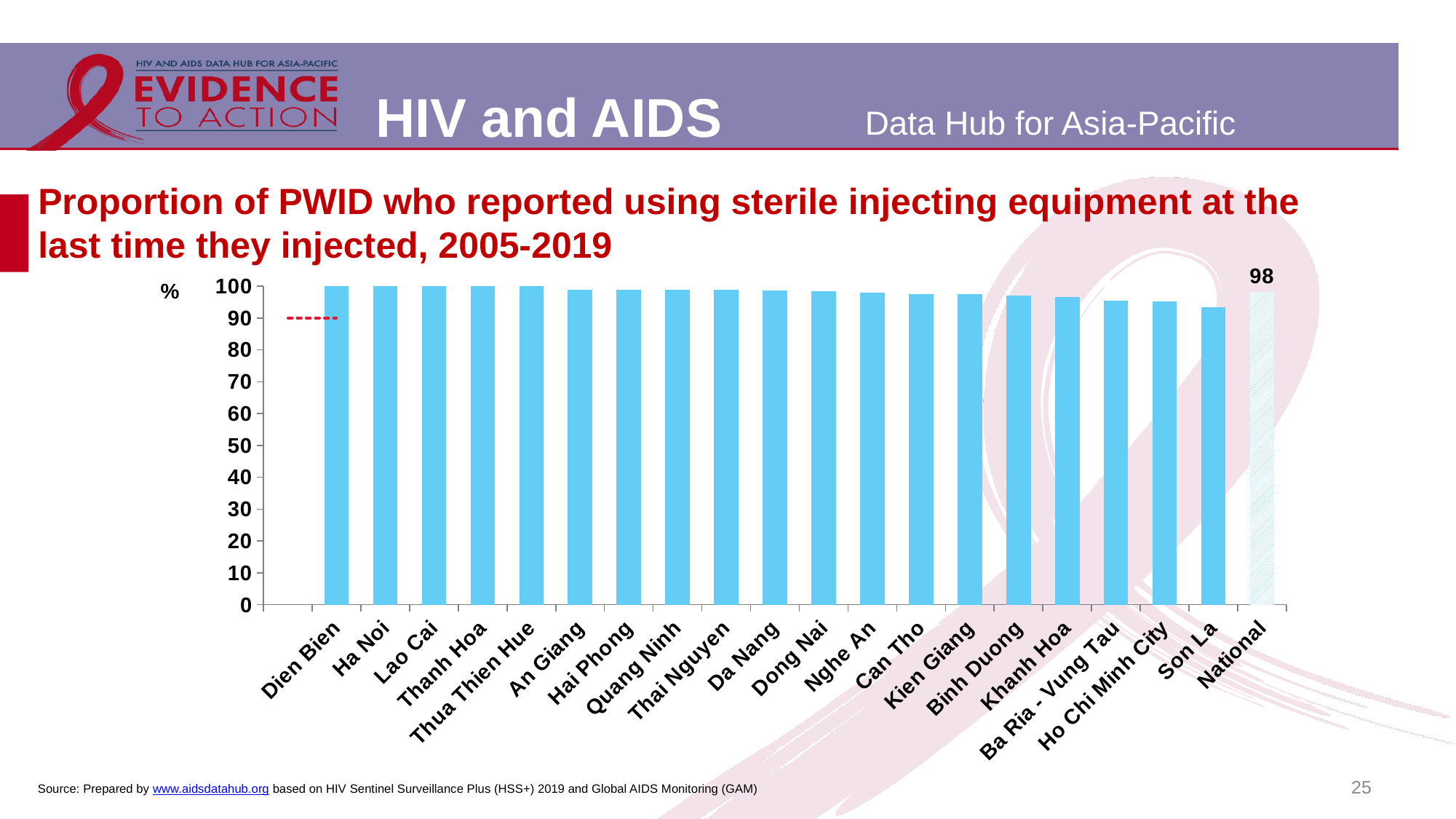
Is the value for Son La greater or less than 90? greater Which has the larger value, Ha Noi or Ho Chi Minh City? Ha Noi What kind of chart is shown on the slide? bar chart Do the bar values generally rise or fall from left to right across the chart? fall What is the value shown for National? 98 What is the title of the chart? Proportion of PWID who reported using sterile injecting equipment at the last time they injected, 2005-2019 How many bars are plotted in the chart? 20 Is the value for Ho Chi Minh City greater or less than 90? greater Which has the larger value, Dien Bien or Son La? Dien Bien What unit is shown on the y axis of the chart? % Which category has the lowest bar in the chart? Son La Is the value for Khanh Hoa greater or less than 80? greater